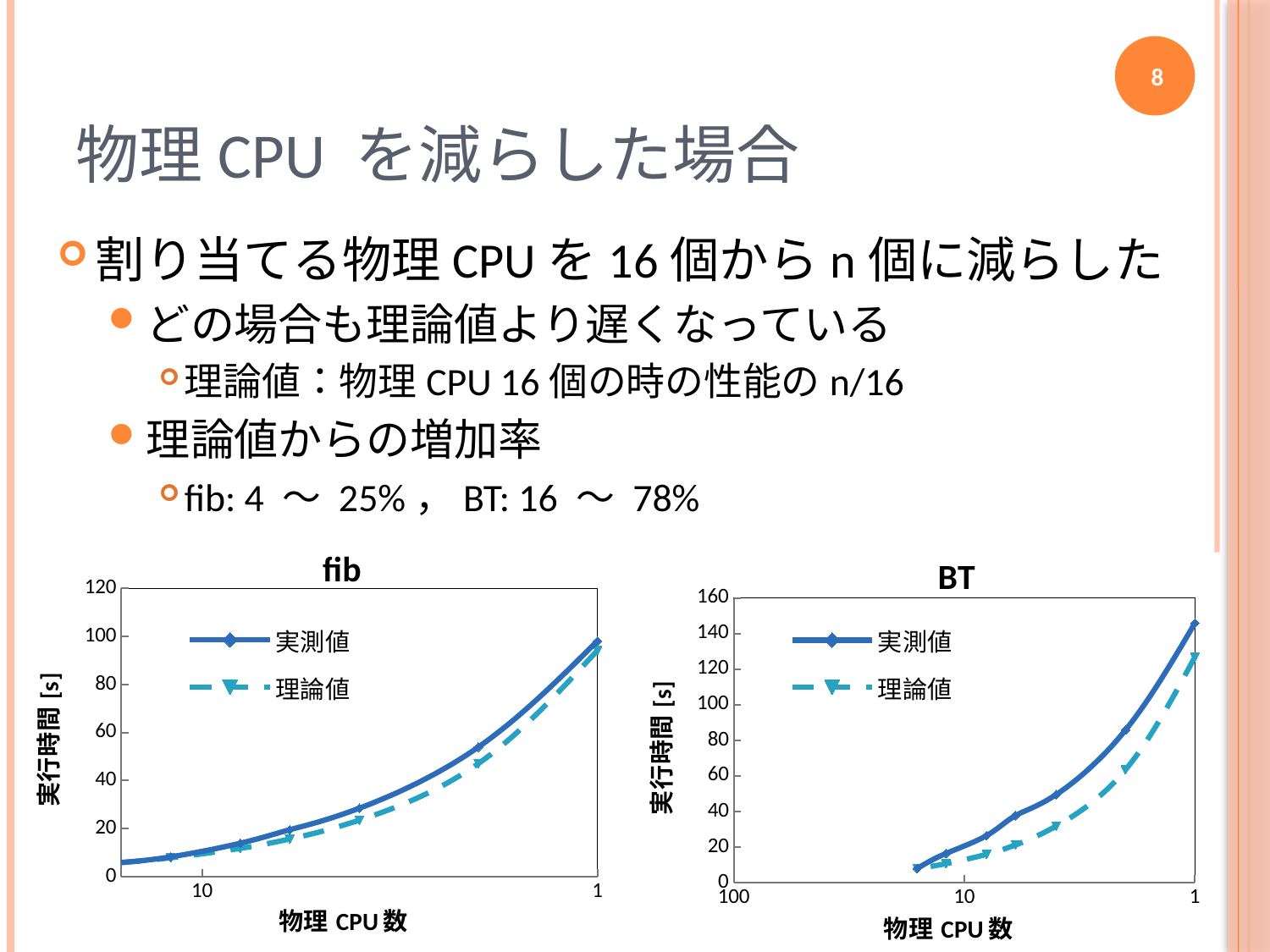
In the BT chart, is the 実測値 value at 1 physical CPU greater or less than 120? greater In the fib chart, does the 実測値 line rise or fall as the number of physical CPUs decreases from left to right? rises In the BT chart, does the 理論値 line rise or fall moving from left to right along the x axis? rises In the BT chart, is the 理論値 value at 1 physical CPU greater or less than 140? less In the BT chart, at 1 physical CPU, which series has the larger value, 実測値 or 理論値? 実測値 What kind of chart is the fib chart? line chart In the fib chart, is the 実測値 value at 1 physical CPU greater or less than 80? greater How many series does the legend of the BT chart list? 2 What are the two legend entries in the fib chart? 実測値, 理論値 What is the y-axis title of the BT chart? 実行時間 [s]